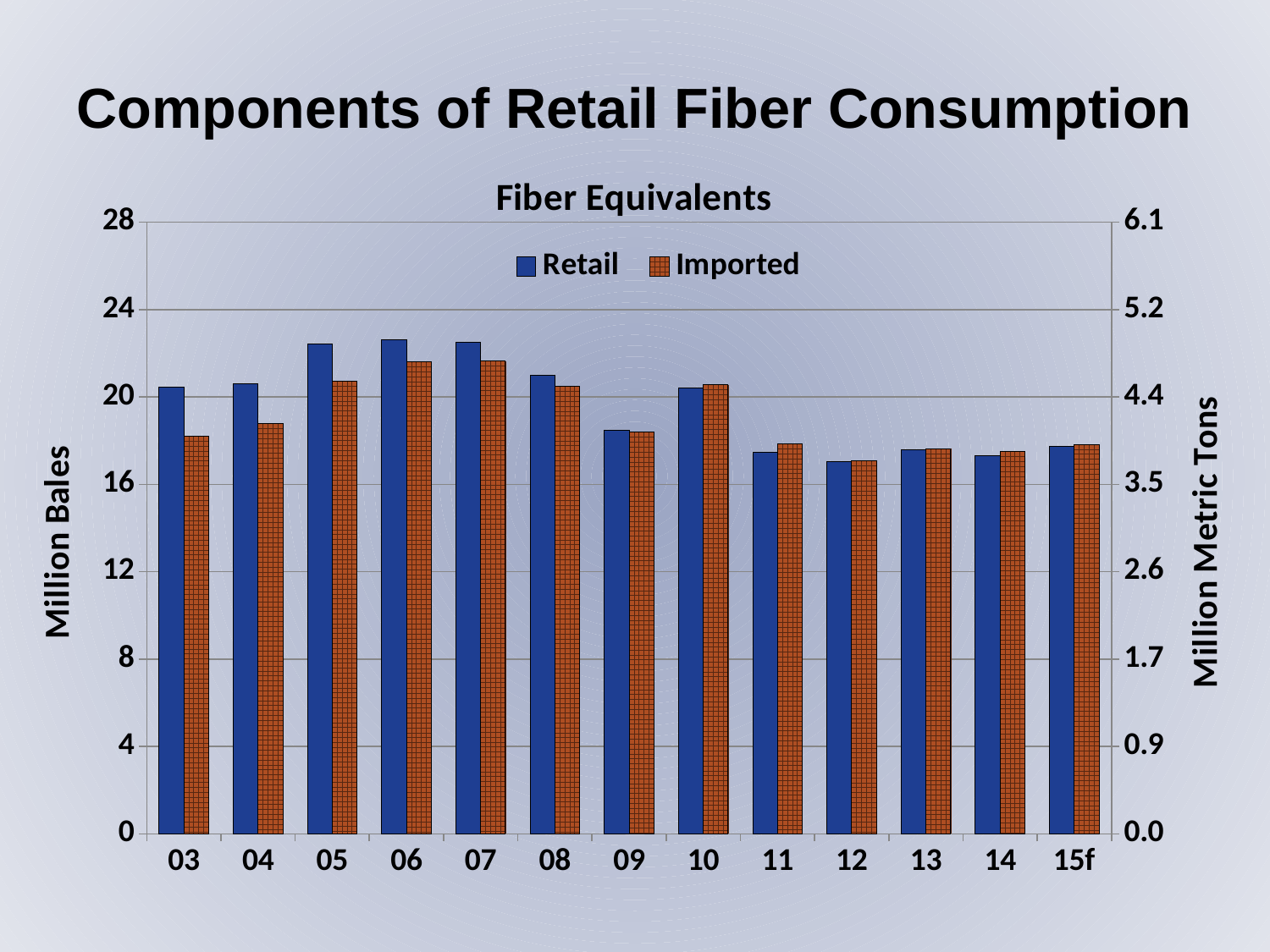
Is the Imported value for 06 greater or less than 20 million bales? greater Which is larger, the Retail value for 05 or the Retail value for 09? 05 Is the Retail value for 09 greater or less than 16 million bales? greater Is the Imported value for 03 greater or less than 20 million bales? less Which is larger for 11, the Retail value or the Imported value? Imported What is the title of the left vertical axis? Million Bales Which is larger for 03, the Retail value or the Imported value? Retail How many years are shown along the x axis? 13 Do the Retail values rise or fall from 07 to 12? fall What kind of chart is shown on the slide? bar chart How many series does the legend list? 2